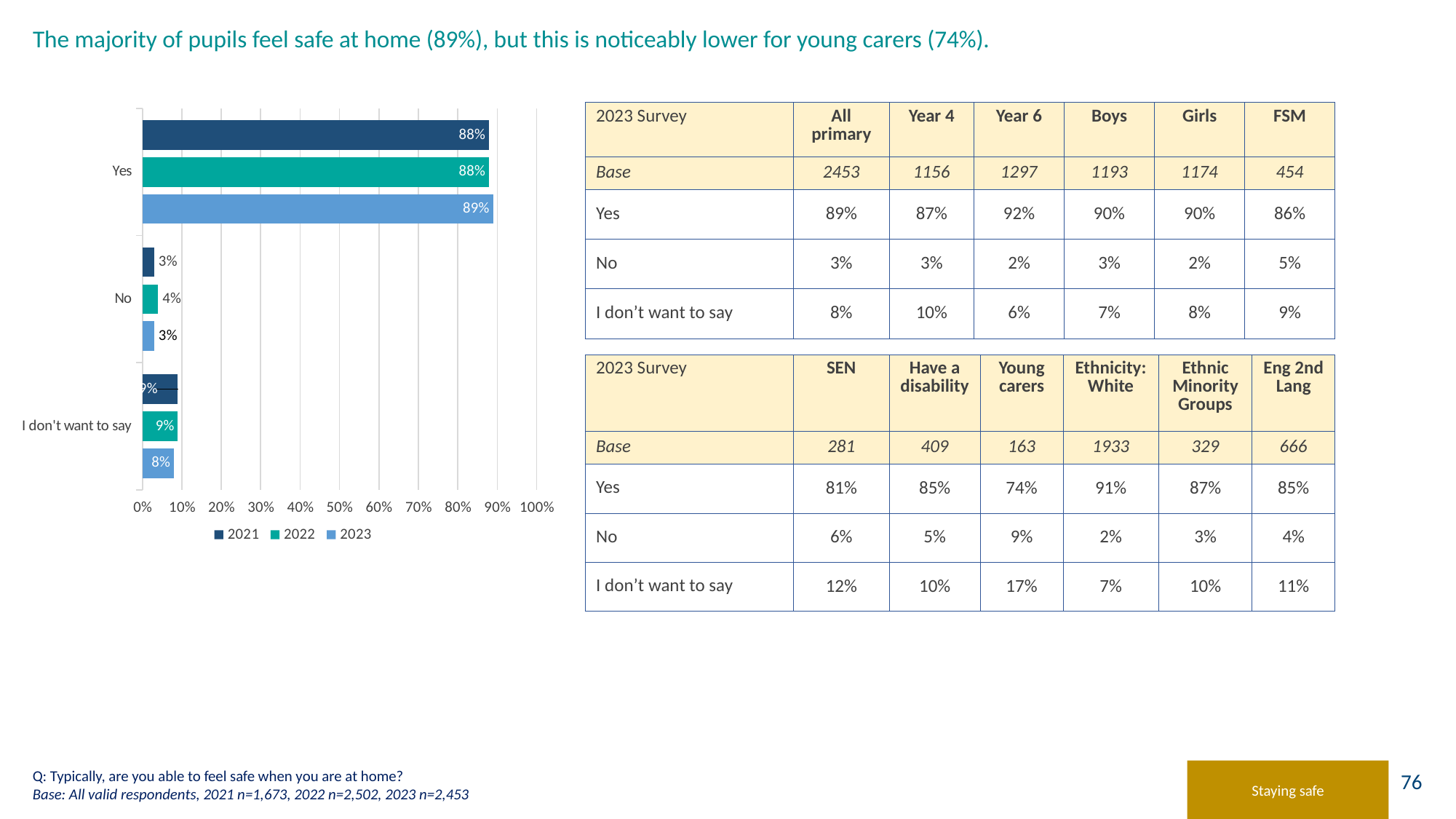
What type of chart is shown on the slide? bar chart What is the difference between the 2023 'Yes' value and the 2022 'Yes' value on the chart? 1% What is the value for 'No' in 2023 on the chart? 3% Which response category has the lowest value in 2022 on the chart? No Which series is shown in the darkest blue colour in the chart legend? 2021 What is the value for 'Yes' in 2021 on the chart? 88% How many series does the chart legend list? 3 Which response category has the highest value in 2023 on the chart? Yes What is the value for 'Yes' in 2023 on the chart? 89% How many response categories are shown on the chart? 3 What is the value for 'I don't want to say' in 2023 on the chart? 8% What is the value for 'No' in 2022 on the chart? 4%